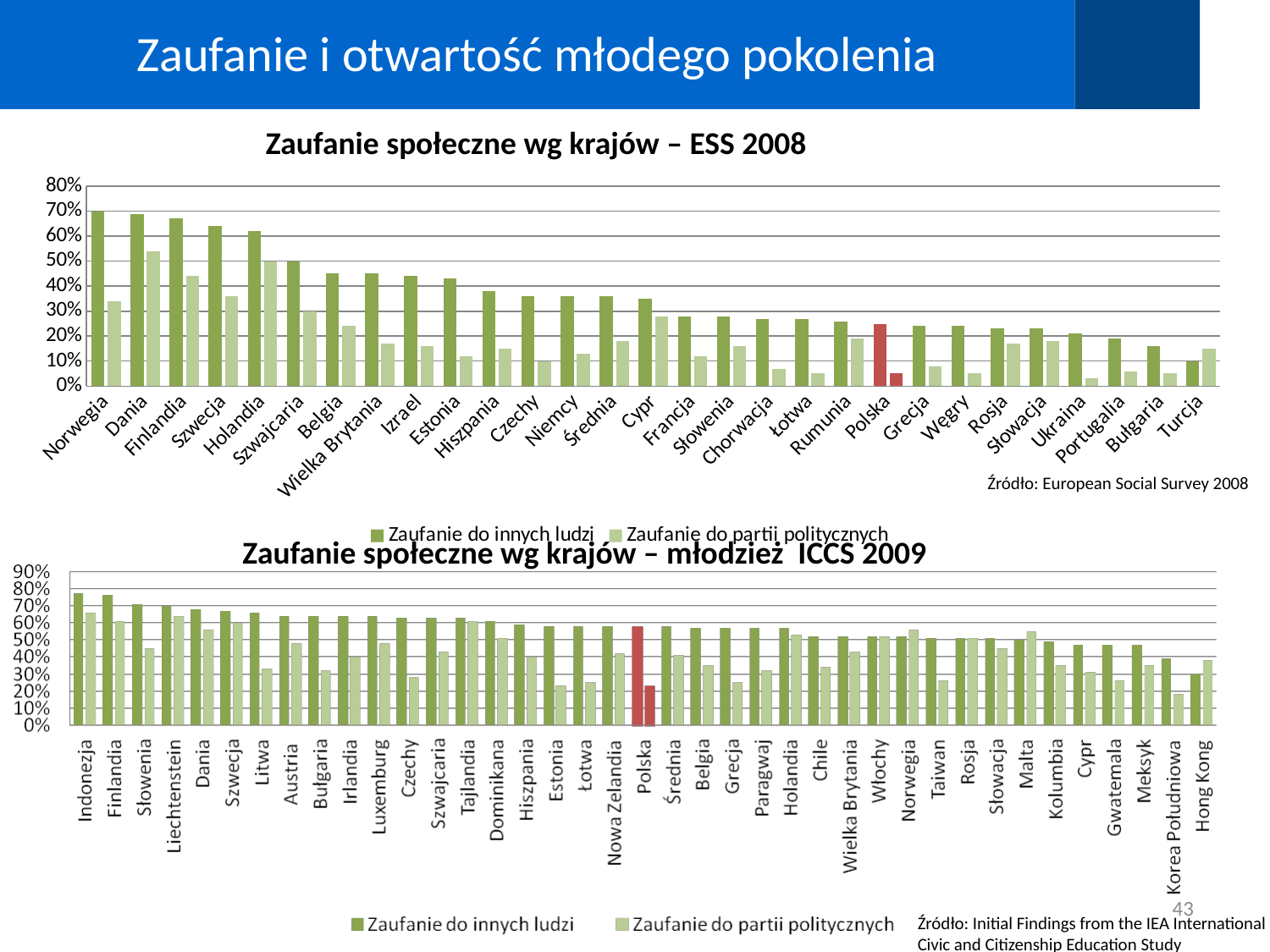
What type of chart is the top chart titled 'Zaufanie społeczne wg krajów – ESS 2008'? bar chart In the top chart (ESS 2008), which category has the lowest value for 'Zaufanie do innych ludzi'? Turcja In the top chart (ESS 2008), which category has the highest value for 'Zaufanie do partii politycznych'? Dania In the top chart (ESS 2008), do the values of 'Zaufanie do innych ludzi' rise or fall from left to right along the x axis? fall In the top chart (ESS 2008), is the value of 'Zaufanie do innych ludzi' for Polska greater or less than 30%? less In the bottom chart (ICCS 2009), is the value of 'Zaufanie do innych ludzi' for Polska greater or less than 50%? greater In the bottom chart (ICCS 2009), which category has the lowest value for 'Zaufanie do innych ludzi'? Hong Kong In the bottom chart (ICCS 2009), which is larger for 'Zaufanie do innych ludzi': Indonezja or Hong Kong? Indonezja In the top chart (ESS 2008), how many countries/categories are shown on the x axis? 29 In the top chart (ESS 2008), how many series does the legend list? 2 In the bottom chart (ICCS 2009), how many countries/categories are shown on the x axis? 39 In the top chart (ESS 2008), which colour is used for the 'Zaufanie do innych ludzi' bar of Polska? red